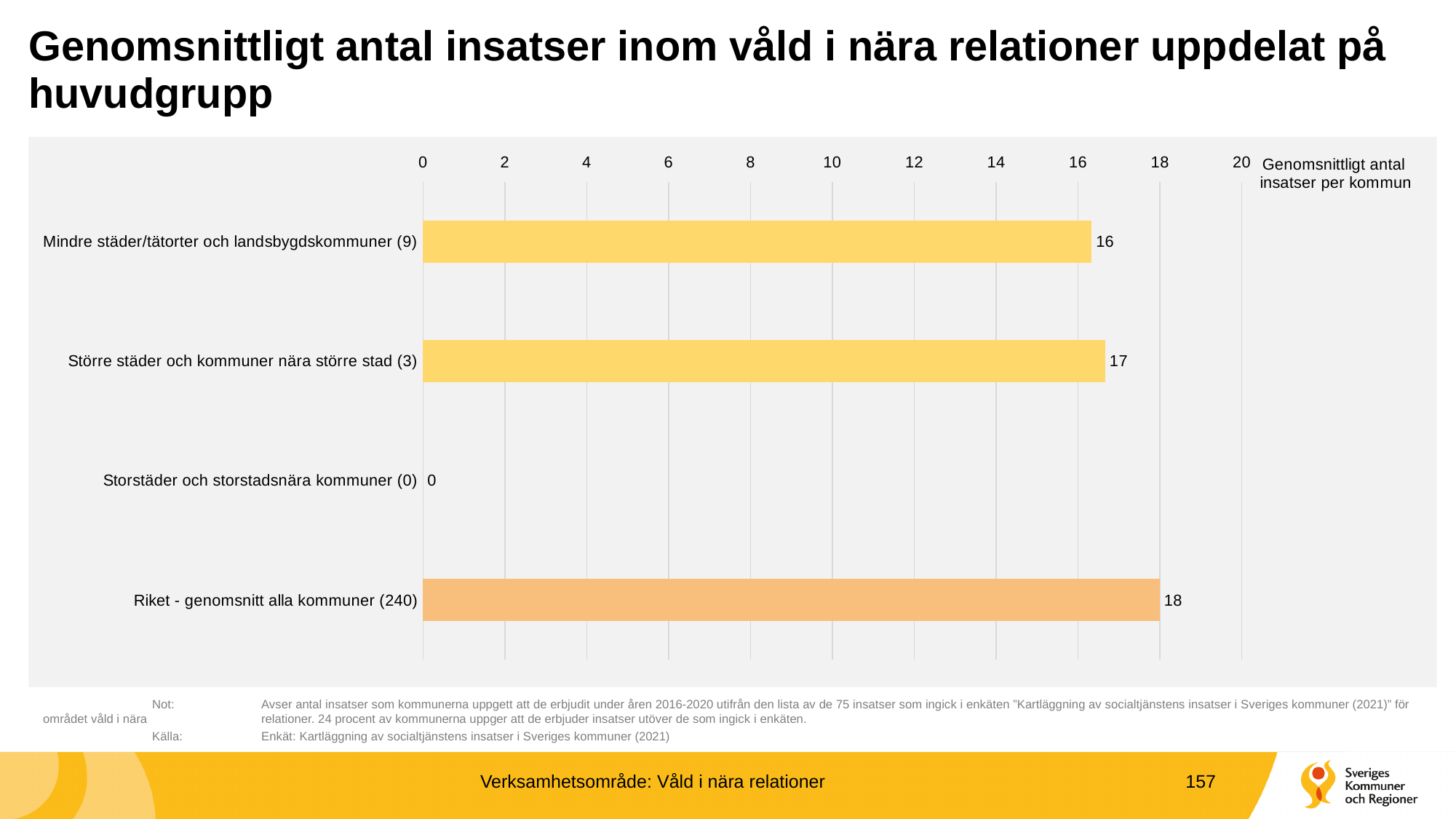
What is the value for Riket - genomsnitt alla kommuner (240)? 18 Which category has the highest value? Riket - genomsnitt alla kommuner (240) What is the value for Mindre städer/tätorter och landsbygdskommuner (9)? 16 What kind of chart is shown on the slide? bar chart Is the value for Större städer och kommuner nära större stad (3) greater or less than 10? greater Which is larger: the value for Större städer och kommuner nära större stad (3) or Mindre städer/tätorter och landsbygdskommuner (9)? Större städer och kommuner nära större stad (3) How many categories are shown in the chart? 4 Which category has the lowest value? Storstäder och storstadsnära kommuner (0) What is the value for Storstäder och storstadsnära kommuner (0)? 0 What is the label shown at the top right of the chart's value axis? Genomsnittligt antal insatser per kommun What is the value for Större städer och kommuner nära större stad (3)? 17 What is the difference between the values for Riket - genomsnitt alla kommuner (240) and Mindre städer/tätorter och landsbygdskommuner (9)? 2